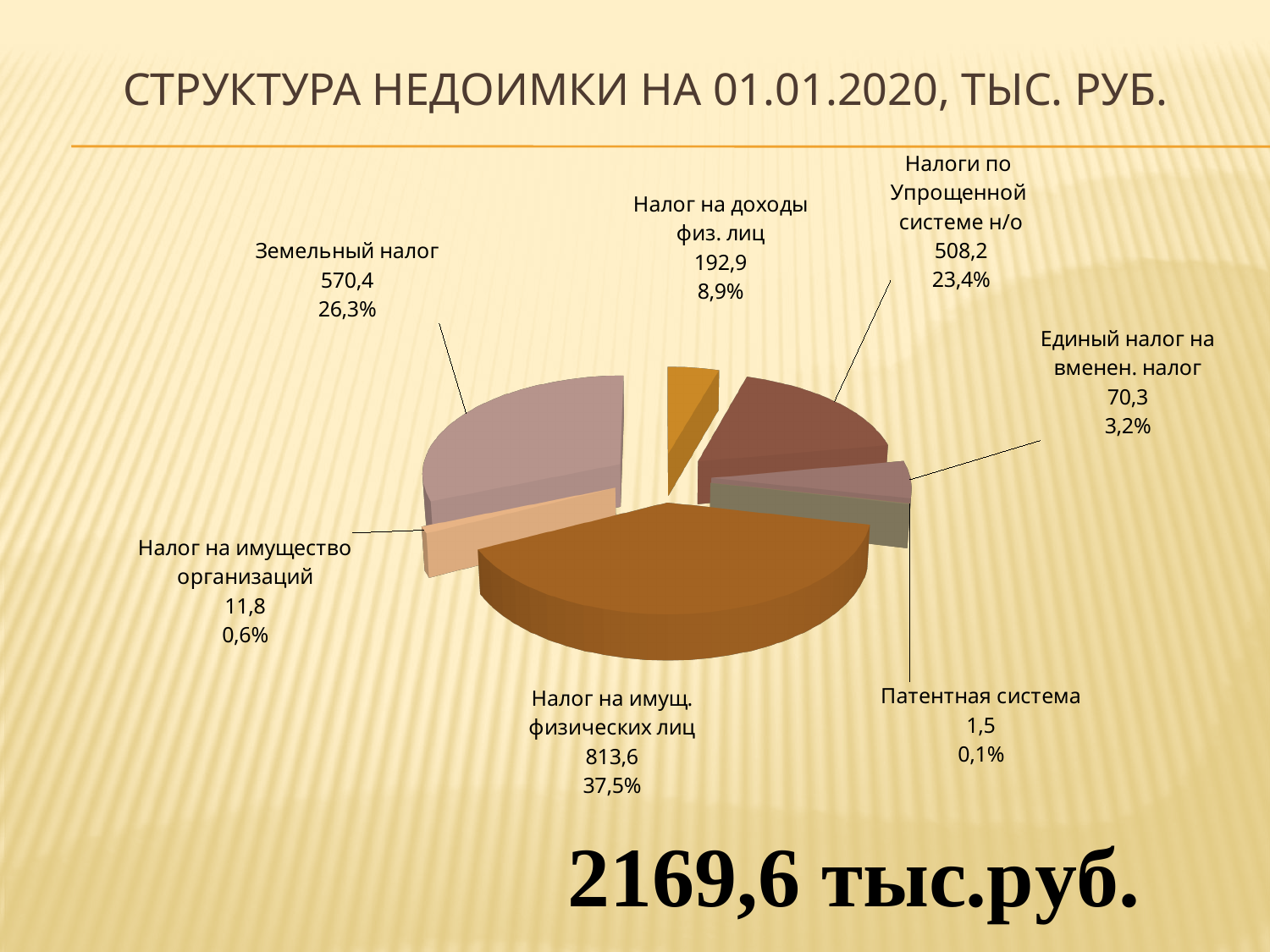
What share of the pie does Налог на имущ. физических лиц represent? 37,5% What is the value for Земельный налог? 570,4 Which is larger, Земельный налог or Налоги по Упрощенной системе н/о? Земельный налог What is the difference between the values for Налог на имущ. физических лиц and Земельный налог? 243,2 What percentage is shown for Патентная система? 0,1% How many slices does the pie chart have? 7 What type of chart is shown on the slide? Pie chart Which category has the largest slice of the pie? Налог на имущ. физических лиц Which category has the smallest slice of the pie? Патентная система What is the value for Единый налог на вменен. налог? 70,3 What is the value for Налоги по Упрощенной системе н/о? 508,2 What is the title of the chart? СТРУКТУРА НЕДОИМКИ НА 01.01.2020, ТЫС. РУБ.